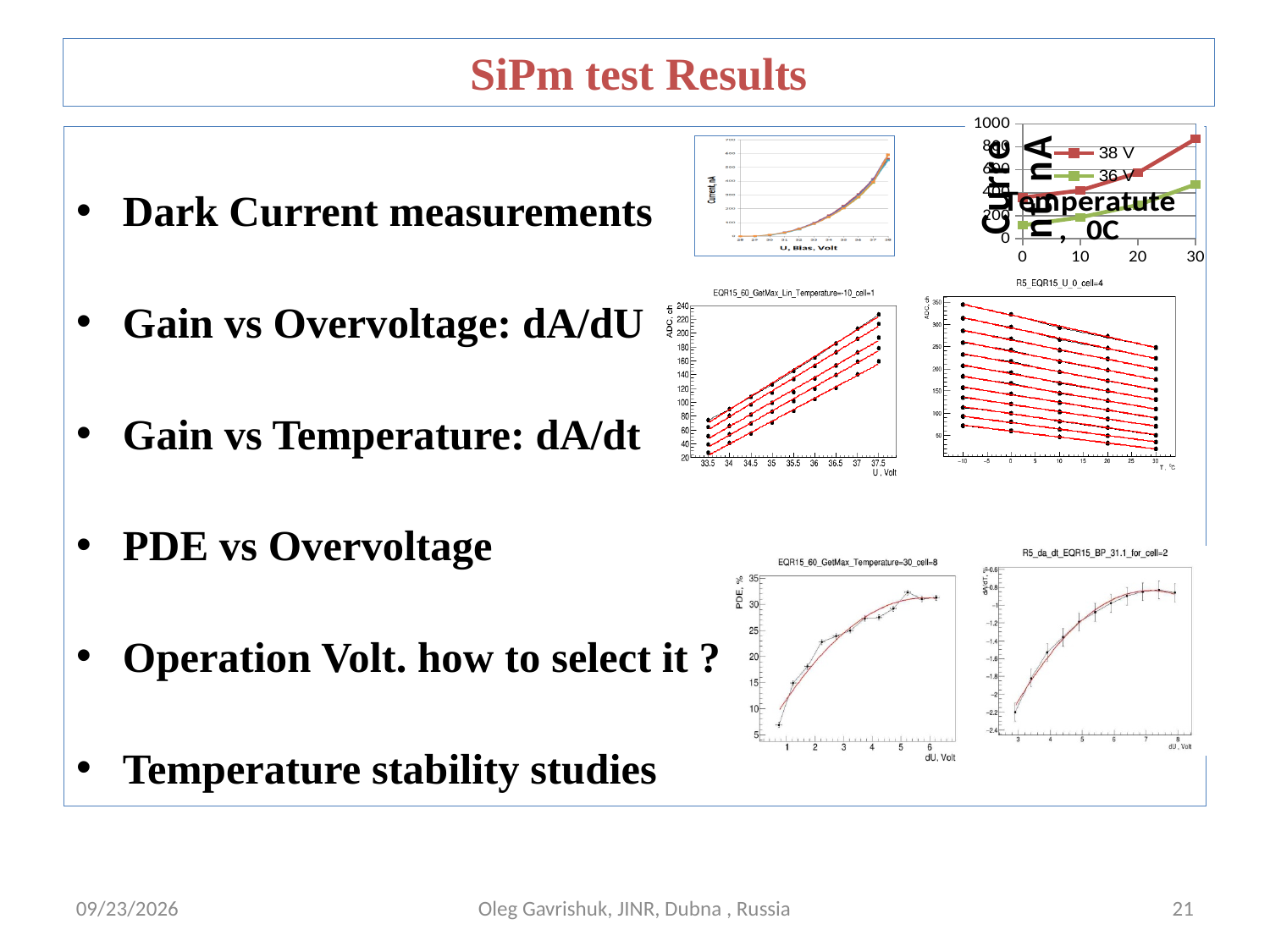
In the PDE, % versus dU, Volt chart, is the PDE at dU = 6 greater or less than 30? greater In the top-right chart of Current, nA versus Temperature, does the current rise or fall as temperature increases? rise In the top-right chart of Current, nA versus Temperature, which series has the larger current at 30 degrees, 38 V or 36 V? 38 V In the top-right chart of Current, nA versus Temperature, what are the two legend entries? 38 V and 36 V In the top-right chart of Current, nA versus Temperature, is the 36 V current at 30 degrees greater or less than 800? less In the top-right chart of Current, nA versus Temperature, what kind of chart is it? line chart In the top-right chart of Current, nA versus Temperature, is the 38 V current at 30 degrees greater or less than 800? greater In the ADC, ch versus U, Volt chart (middle, titled EQR15_60_GetMax_Lin_Temperature=-10_cell=1), do the ADC values rise or fall as voltage increases? rise In the PDE, % versus dU, Volt chart (bottom, left of the pair), does PDE rise or fall as dU increases? rise In the top-right chart of Current, nA versus Temperature, how many series does the legend list? 2